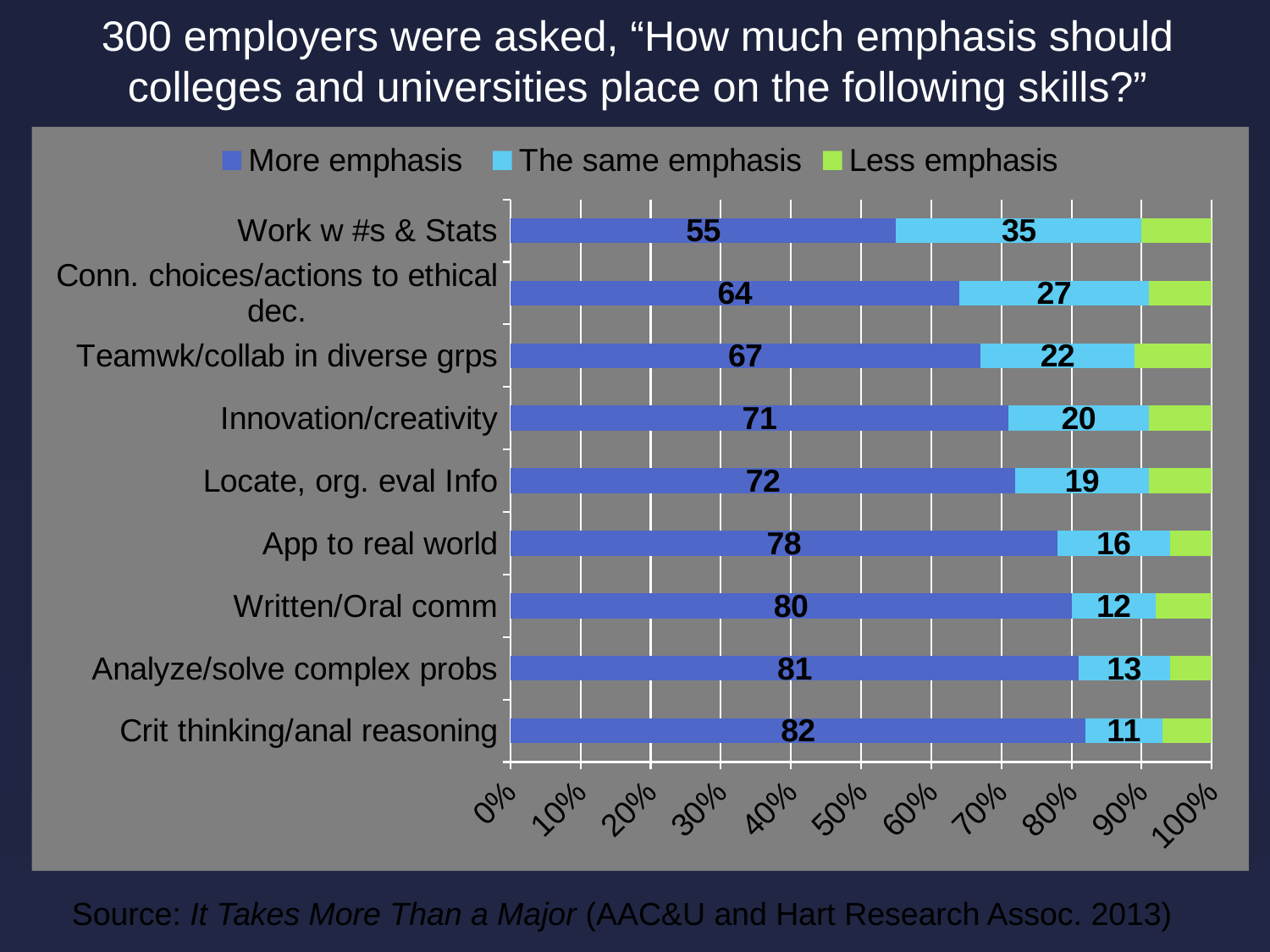
What is the 'The same emphasis' value for Work w #s & Stats? 35 Which is larger, the 'The same emphasis' value for Teamwk/collab in diverse grps or for Written/Oral comm? Teamwk/collab in diverse grps Which category has the highest 'More emphasis' value? Crit thinking/anal reasoning What is the difference between the 'More emphasis' values for App to real world and Work w #s & Stats? 23 What is the 'More emphasis' value for Crit thinking/anal reasoning? 82 How many series does the legend list? 3 What is the 'More emphasis' value for Innovation/creativity? 71 Which legend entry is shown in green? Less emphasis How many skill categories are plotted in the chart? 9 Is the 'More emphasis' value for Locate, org. eval Info greater or less than 60%? greater What kind of chart is shown on the slide? Stacked bar chart Which category has the lowest 'More emphasis' value? Work w #s & Stats